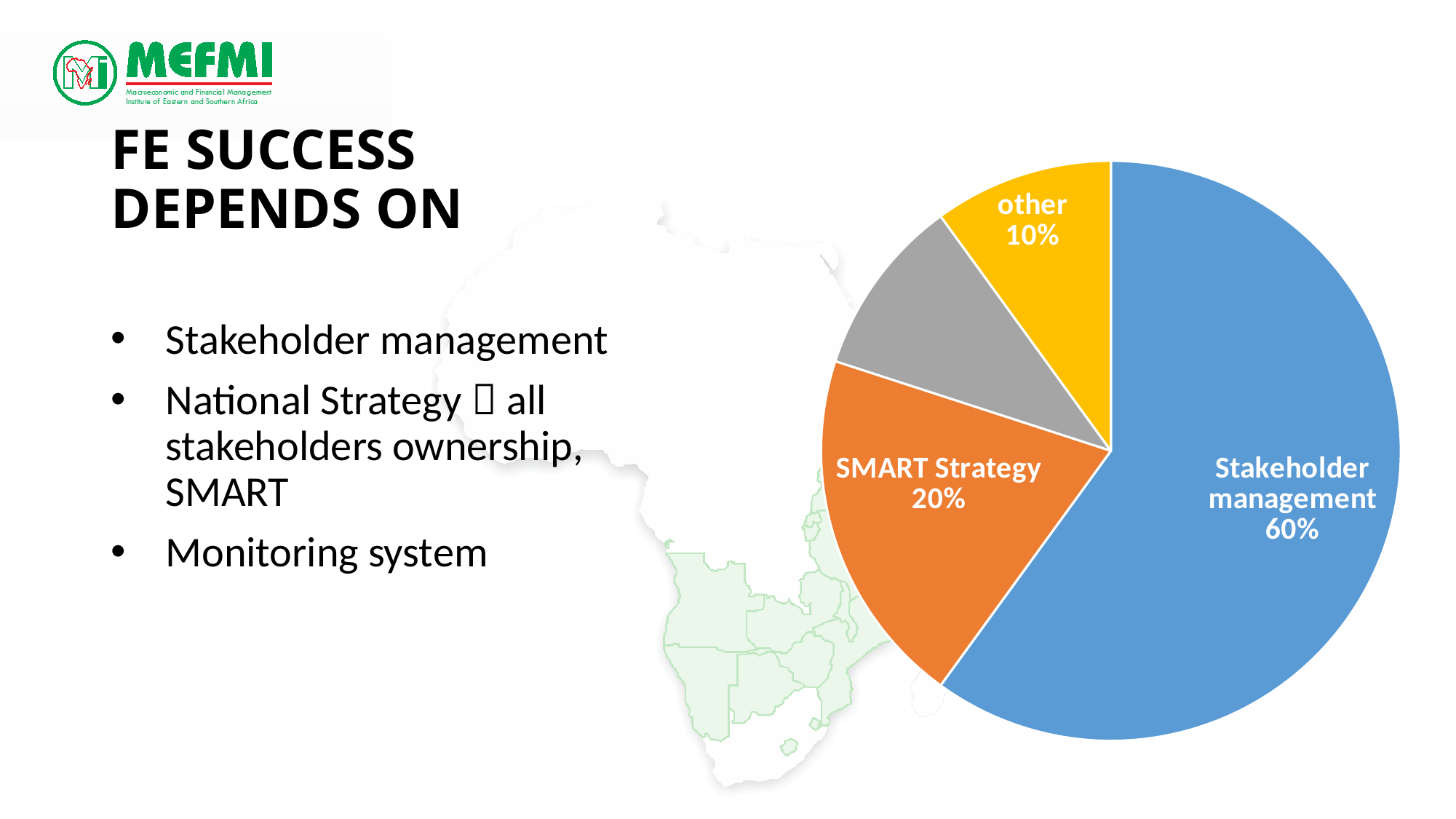
Is the share for Stakeholder management greater or less than 50%? greater What share of the pie does the 'other' slice take? 10% Which labelled slice of the pie is the smallest? other How many slices does the pie chart have? 4 What kind of chart is shown on the slide? pie chart What is the difference in percentage points between SMART Strategy and other? 10 What share of the pie does SMART Strategy take? 20% What share of the pie does Stakeholder management take? 60% What colour is the Stakeholder management slice? blue Which labelled slice of the pie is the largest? Stakeholder management What is the difference in percentage points between Stakeholder management and SMART Strategy? 40 Which is larger, the SMART Strategy slice or the other slice? SMART Strategy